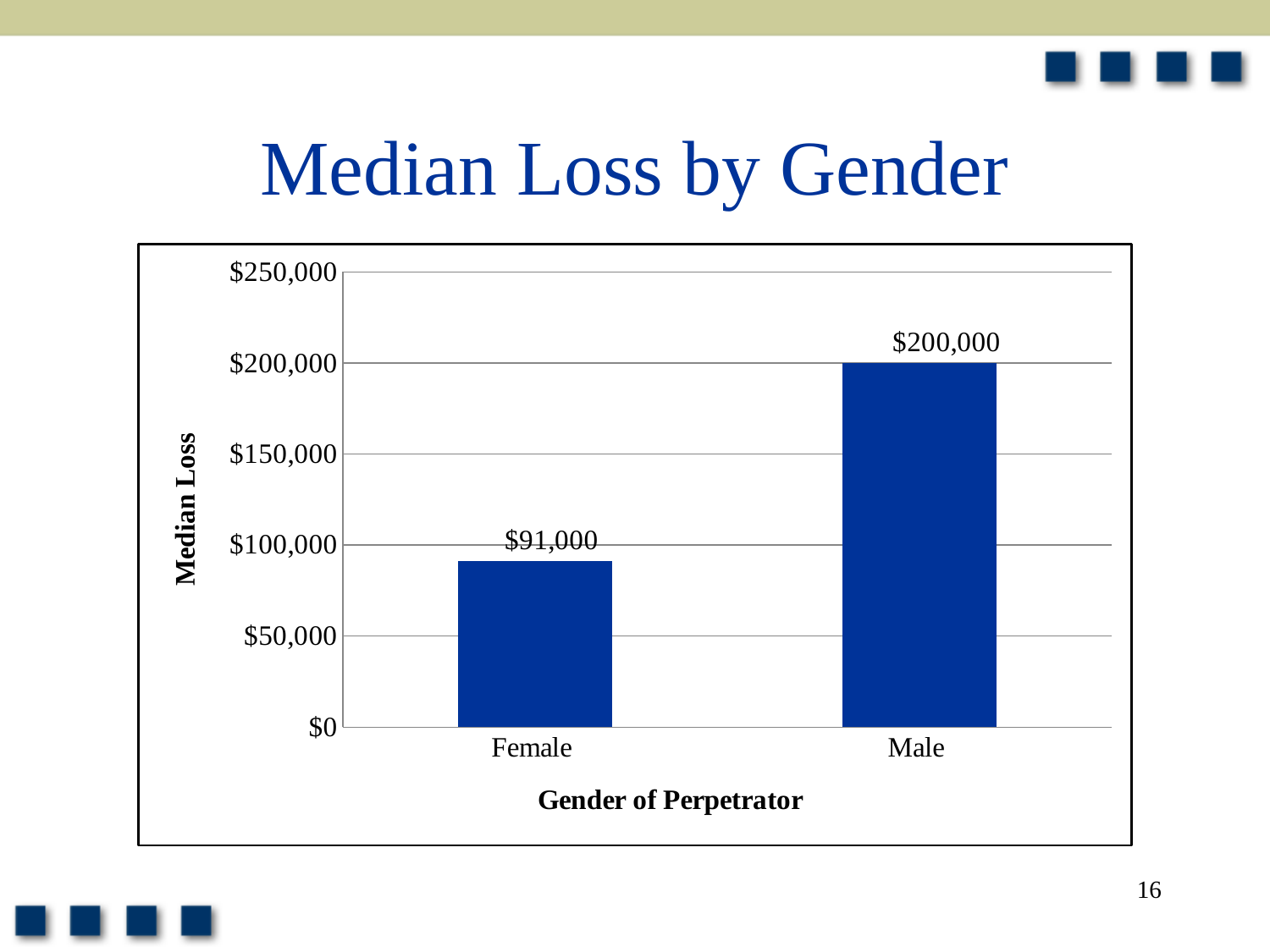
Which gender has the lower median loss? Female Is the median loss for Female perpetrators greater or less than $100,000? less What is the highest value shown on the y axis? $250,000 What is the title of the chart? Median Loss by Gender How many categories are shown on the x axis? 2 Is the median loss for Male perpetrators greater or less than $150,000? greater Which gender has the higher median loss? Male What is the median loss for Female perpetrators? $91,000 What kind of chart is shown on the slide? bar chart What is the difference between the median loss for Male and Female perpetrators? $109,000 What is the label of the x axis? Gender of Perpetrator What is the median loss for Male perpetrators? $200,000